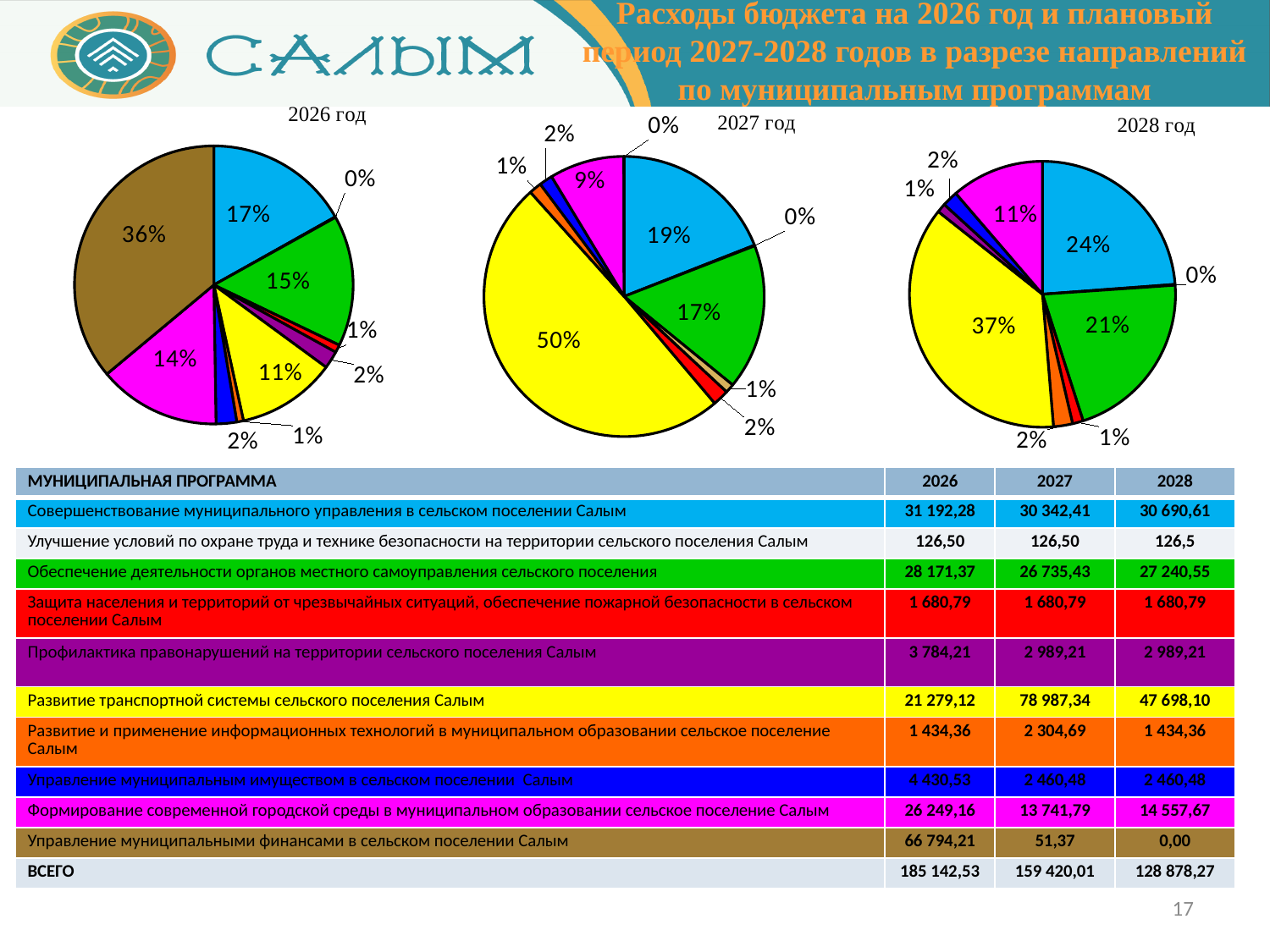
How many pie charts are shown on the slide? 3 In the 2026 год pie chart, what is the share of the largest slice (brown)? 36% In the 2026 год pie chart, what share does the light blue slice have? 17% In the 2028 год pie chart, what is the share of the largest slice (yellow)? 37% In the 2028 год pie chart, what share does the light blue slice have? 24% In the 2026 год pie chart, what is the combined share of the light blue and green slices? 32% In the 2028 год pie chart, what share does the magenta slice have? 11% What type of chart is used for the 2026 год, 2027 год and 2028 год charts? pie chart In the 2026 год pie chart, which slice is larger: the magenta slice or the yellow slice? magenta slice What is the difference between the yellow slice's share in the 2027 год chart and in the 2028 год chart? 13% In the 2027 год pie chart, what share does the green slice have? 17% In the 2027 год pie chart, what is the share of the largest slice (yellow)? 50%